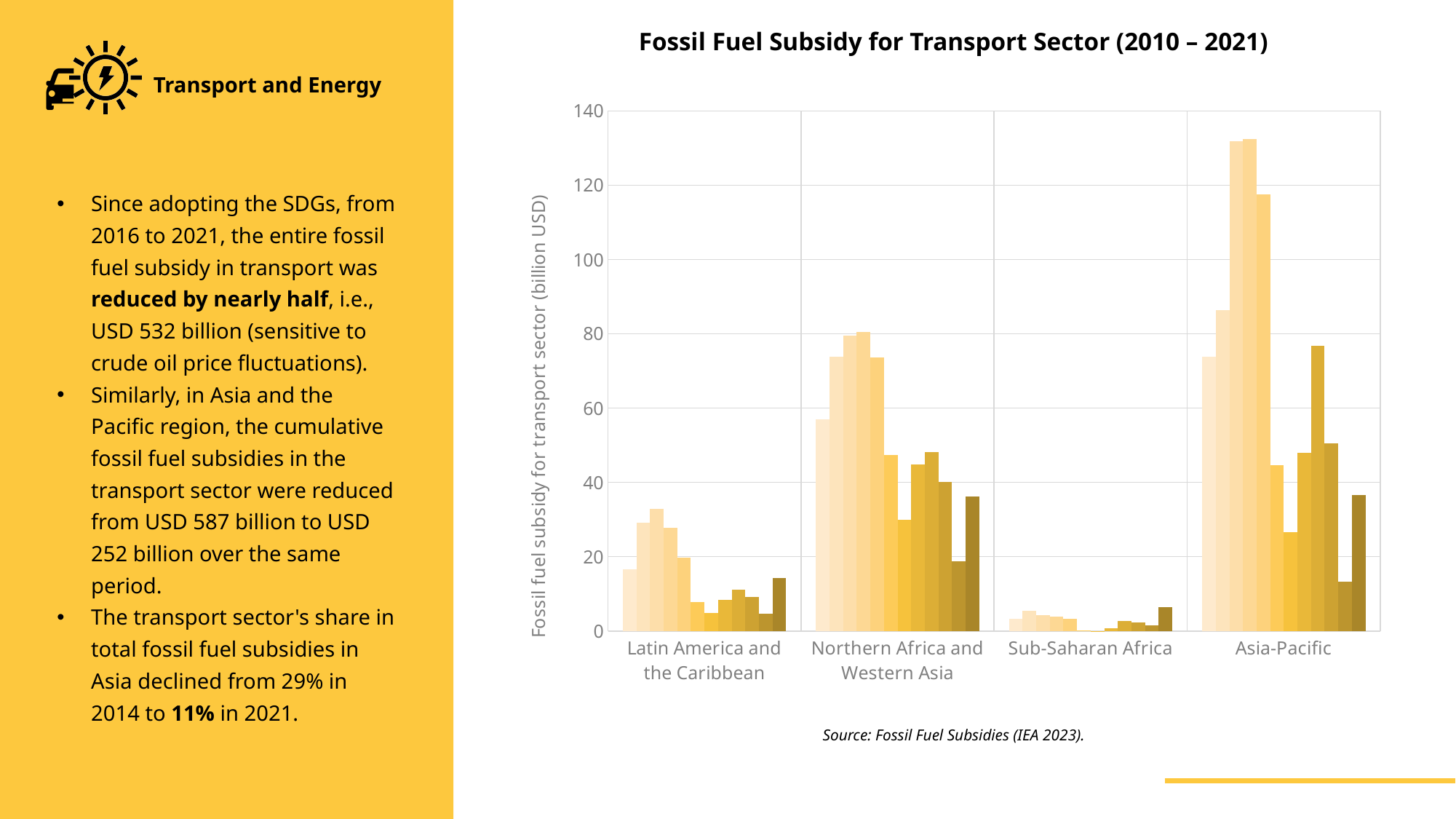
Which region has a higher tallest bar: Northern Africa and Western Asia or Sub-Saharan Africa? Northern Africa and Western Asia What is the title of the chart? Fossil Fuel Subsidy for Transport Sector (2010 – 2021) How many regions are shown along the x axis of the chart? 4 How many bars are plotted for each region in the chart? 12 Which region has the lowest bars overall in the chart? Sub-Saharan Africa What kind of chart is shown on the slide? Bar chart What is the label of the vertical axis of the chart? Fossil fuel subsidy for transport sector (billion USD) Which region has the tallest bar in the chart? Asia-Pacific Is the tallest bar for Northern Africa and Western Asia greater or less than 60? greater Is the tallest bar for Sub-Saharan Africa greater or less than 20? less Is the tallest bar for Asia-Pacific greater or less than 120? greater